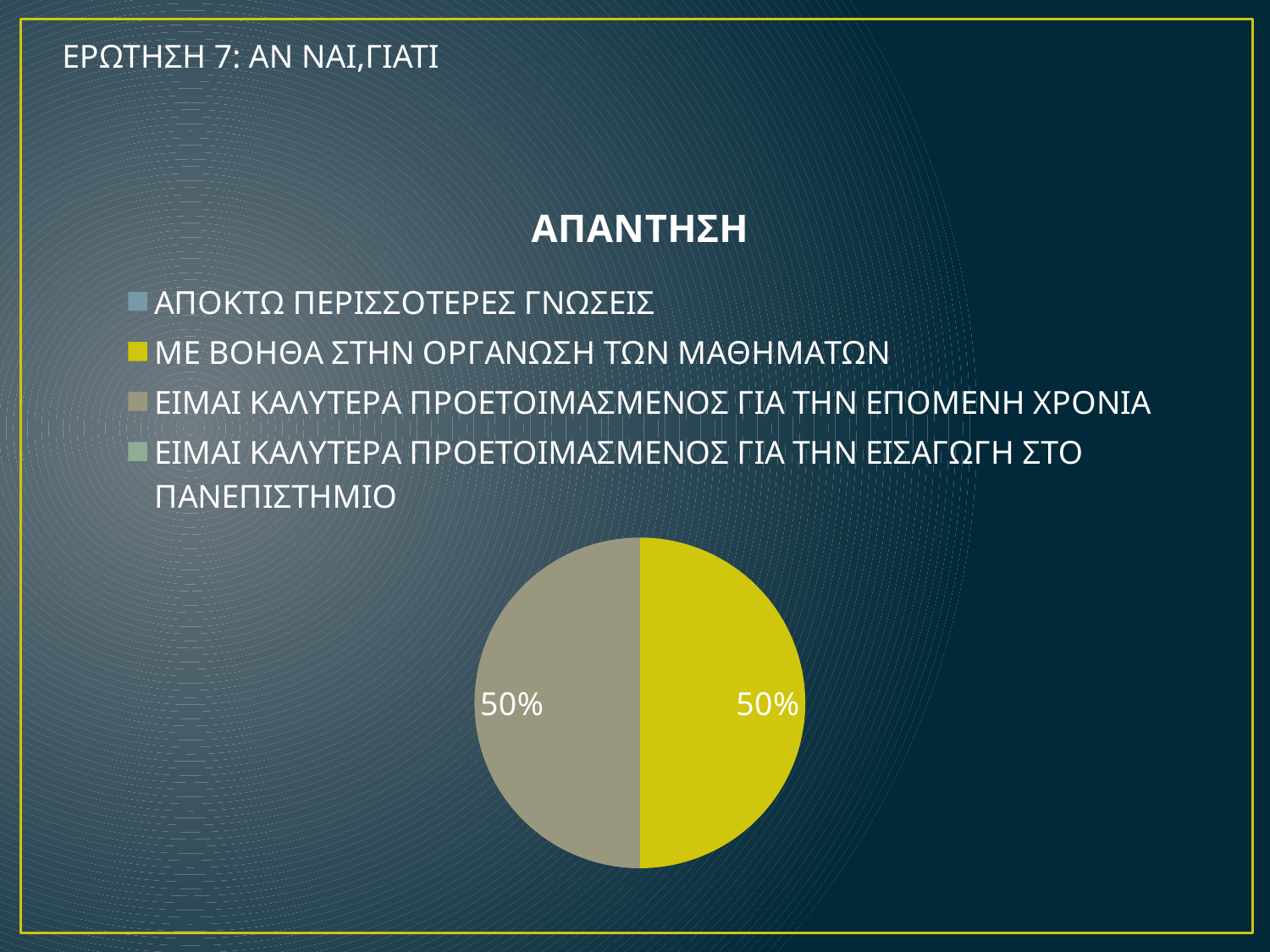
How many entries does the chart legend list? 4 What do the two labelled slices of the pie add up to? 100% What kind of chart is shown on the slide? pie chart What share of the pie does the yellow slice (ΜΕ ΒΟΗΘΑ ΣΤΗΝ ΟΡΓΑΝΩΣΗ ΤΩΝ ΜΑΘΗΜΑΤΩΝ) represent? 50% What is the value printed on the left-hand slice of the pie? 50% How many slices are visible in the pie chart? 2 Which legend entry is shown in yellow? ΜΕ ΒΟΗΘΑ ΣΤΗΝ ΟΡΓΑΝΩΣΗ ΤΩΝ ΜΑΘΗΜΑΤΩΝ What share of the pie does the grey slice (ΕΙΜΑΙ ΚΑΛΥΤΕΡΑ ΠΡΟΕΤΟΙΜΑΣΜΕΝΟΣ ΓΙΑ ΤΗΝ ΕΠΟΜΕΝΗ ΧΡΟΝΙΑ) represent? 50% What is the value printed on the right-hand slice of the pie? 50% What is the title of the chart? ΑΠΑΝΤΗΣΗ What is the difference between the two slice values shown in the pie chart? 0%